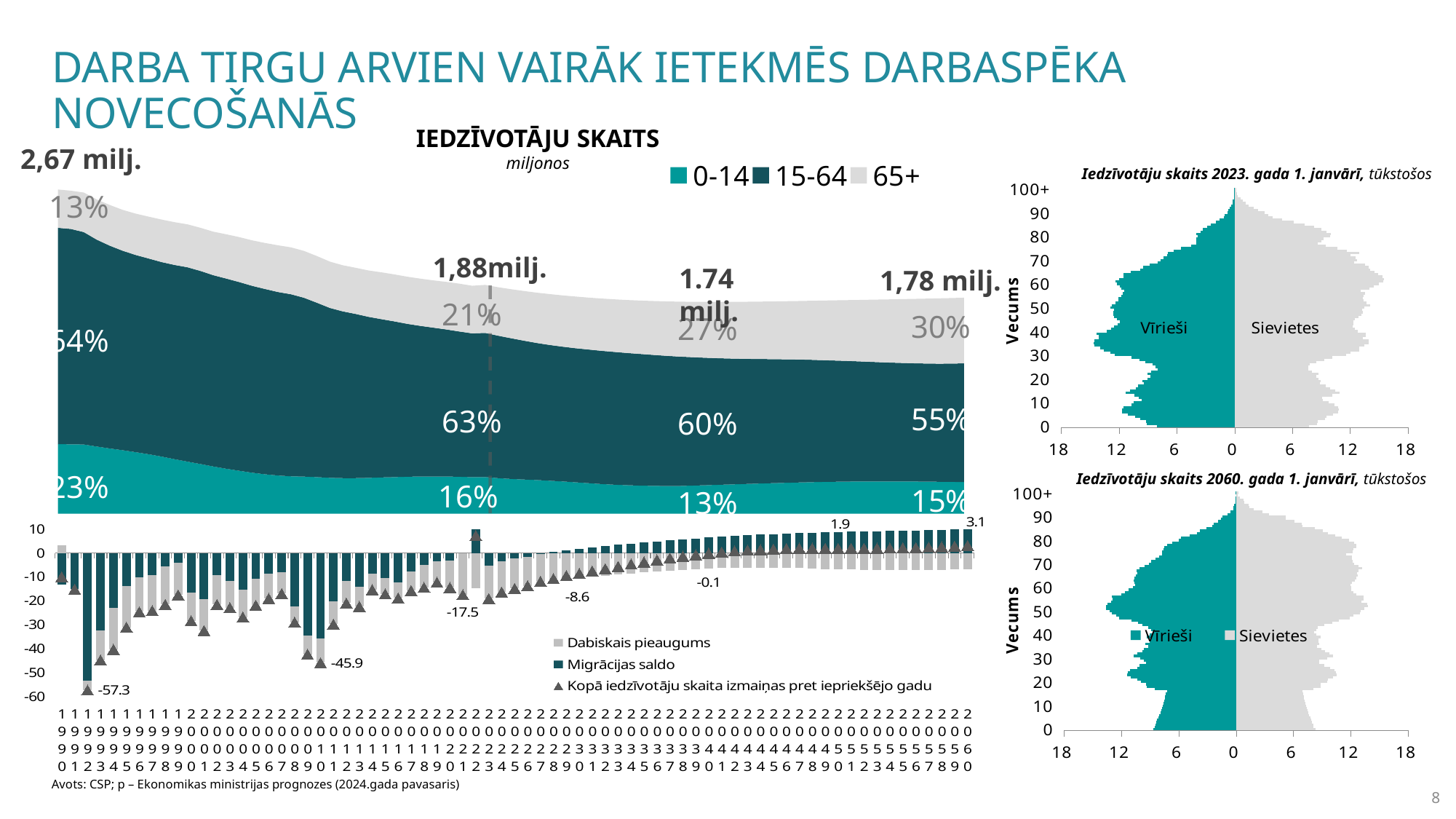
In the IEDZĪVOTĀJU SKAITS area chart, does the share of the 65+ group rise or fall from left to right? Rise In the IEDZĪVOTĀJU SKAITS area chart, is the 0-14 share larger at the left end (23%) or at the right end (15%)? Left end (23%) In the IEDZĪVOTĀJU SKAITS area chart, what share is labelled for the 15-64 group at the left end of the chart? 64% In the IEDZĪVOTĀJU SKAITS area chart, what share is labelled for the 65+ group at the right end of the chart (2060)? 30% In the bottom bar chart with Dabiskais pieaugums and Migrācijas saldo, what is the lowest labelled value? -57.3 In the bottom bar chart, what is the difference between the labelled values -45.9 and -57.3? 11.4 In the bottom bar chart, how many entries does the legend list? 3 In the IEDZĪVOTĀJU SKAITS area chart, how many series does the legend list? 3 In the IEDZĪVOTĀJU SKAITS area chart, what total population is labelled at the left end of the chart? 2,67 milj. What is the title of the top-right population pyramid chart? Iedzīvotāju skaits 2023. gada 1. janvārī, tūkstošos What kind of chart is the IEDZĪVOTĀJU SKAITS chart? Stacked area chart In the IEDZĪVOTĀJU SKAITS area chart, what share is labelled for the 0-14 group at the point marked 1,88milj.? 16%